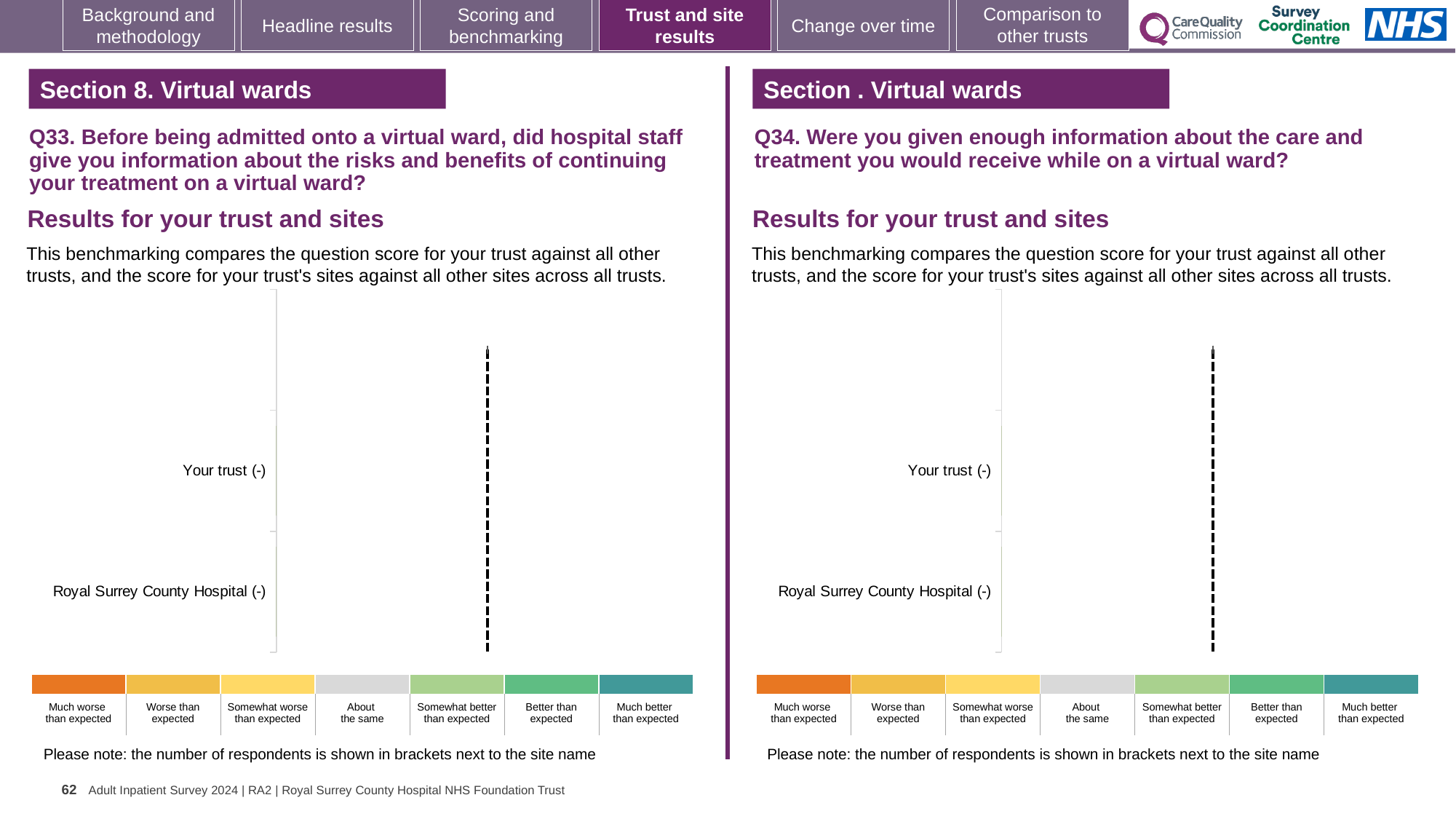
On the left chart (Q33), what is the label of the leftmost (orange) band in the key? Much worse than expected On the left chart (Q33), what is shown in brackets next to 'Royal Surrey County Hospital'? (-) On the left chart (Q33), how many categories are listed on the vertical axis? 2 On the right chart (Q34), how many colour bands does the key below the chart show? 7 On the right chart (Q34), how many categories are listed on the vertical axis? 2